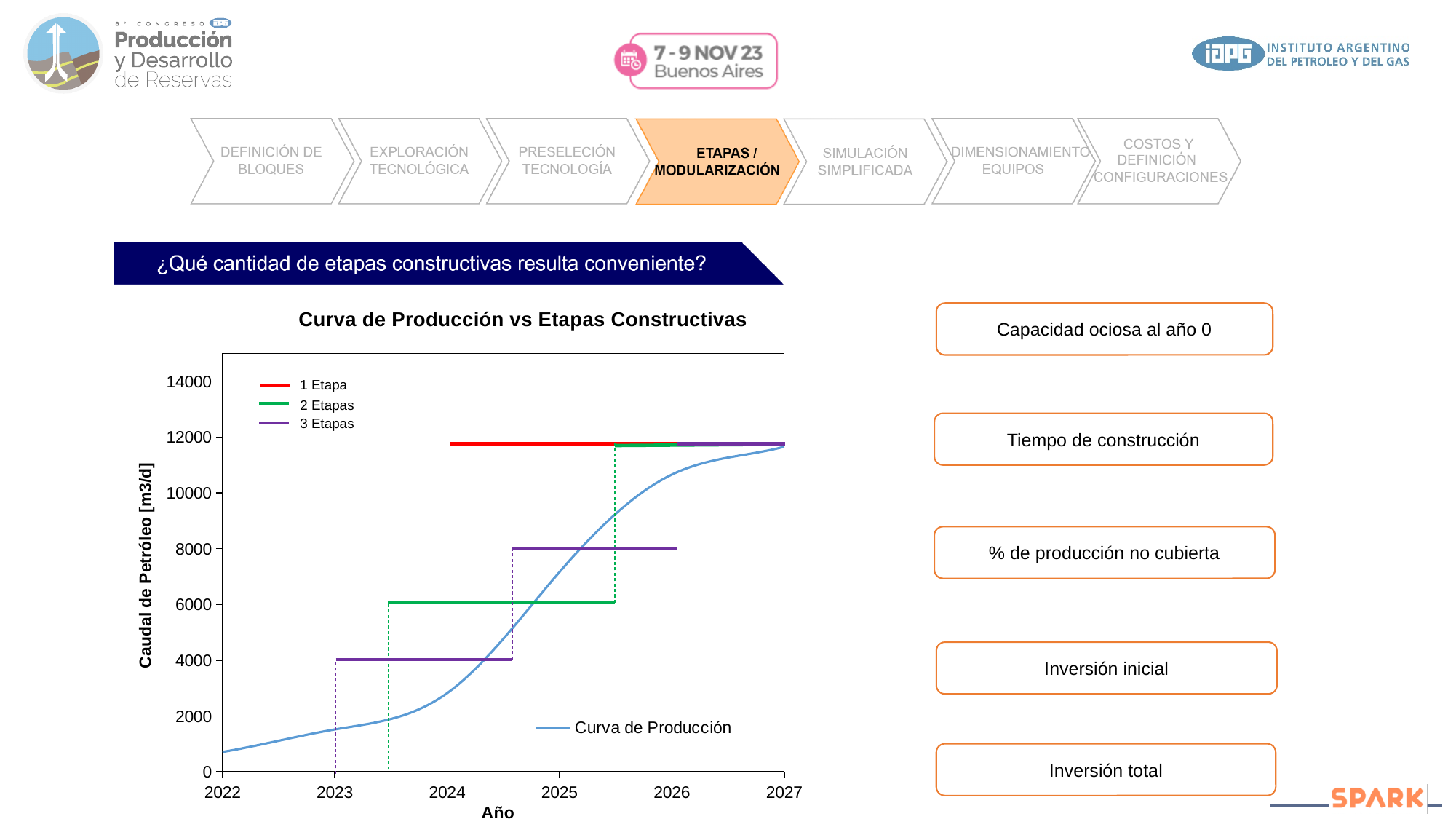
What is the capacity level of the first step of the 2 Etapas series, in m3/d? 6000 How many series does the legend in the upper left of the chart list? 3 What is the title of the chart? Curva de Producción vs Etapas Constructivas Which series is drawn in red in the chart? 1 Etapa Is the capacity level of the 1 Etapa series greater or less than 10000? greater What is the capacity level of the second step of the 3 Etapas series, in m3/d? 8000 Does the Curva de Producción rise or fall from 2022 to 2027? rises What is the difference between the second and first step levels of the 3 Etapas series? 4000 What type of chart is shown on the slide? line chart Is the value of the Curva de Producción at 2022 greater or less than 2000? less At the year 2025, which series has the higher capacity level, 2 Etapas or 3 Etapas? 3 Etapas What is the capacity level of the first step of the 3 Etapas series, in m3/d? 4000